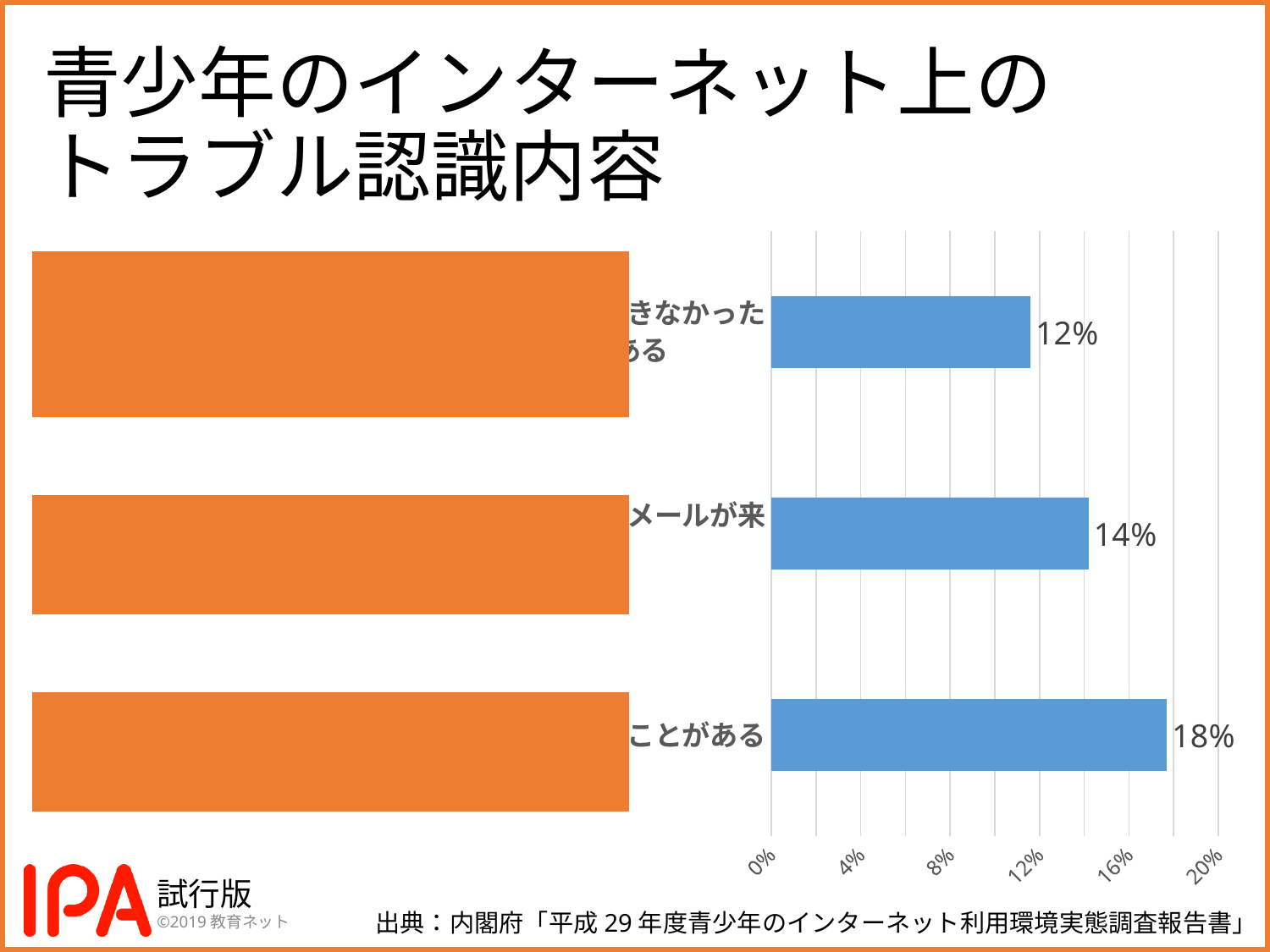
What is the difference between the bottom bar's value and the middle bar's value? 4% How many bars are plotted in the chart? 3 Which bar in the chart has the lowest value? the top bar What kind of chart is shown on the slide? bar chart What is the difference between the bottom bar's value and the top bar's value? 6% What is the value shown for the bottom bar of the chart? 18% What is the value shown for the middle bar of the chart? 14% What is the highest tick label shown on the horizontal axis of the chart? 20% Which bar in the chart has the highest value? the bottom bar Is the value for the bottom bar greater or less than 16%? greater Which is larger, the value of the top bar or the value of the middle bar? the middle bar What is the value shown for the top bar of the chart? 12%